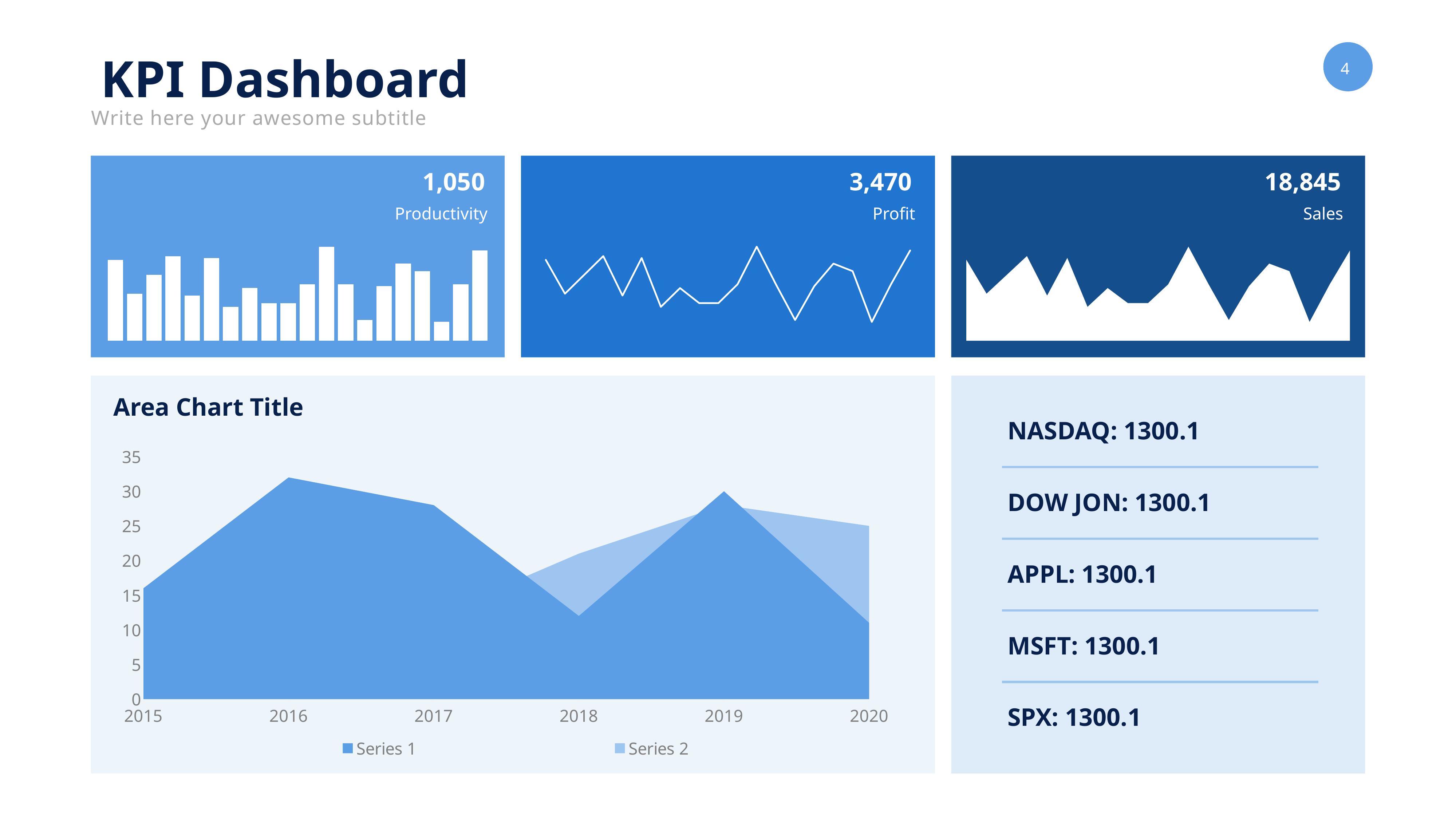
What are the two legend entries of the 'Area Chart Title' chart? Series 1 and Series 2 In the 'Area Chart Title' chart, which year has the highest value for Series 1? 2016 What value is shown on the Productivity KPI card at the top left? 1,050 What value is shown on the Sales KPI card at the top right? 18,845 How many series does the legend of the 'Area Chart Title' chart list? 2 In the 'Area Chart Title' chart, which series has the larger value in 2018: Series 1 or Series 2? Series 2 In the 'Area Chart Title' chart, does Series 1 rise or fall from 2016 to 2018? fall In the 'Area Chart Title' chart, is the Series 1 value for 2018 greater or less than 15? less In the 'Area Chart Title' chart, which is larger for Series 1: the value for 2016 or the value for 2017? 2016 What kind of chart is the 'Area Chart Title' chart? area chart In the 'Area Chart Title' chart, is the Series 1 value for 2016 greater or less than 30? greater How many years are shown on the x axis of the 'Area Chart Title' chart? 6